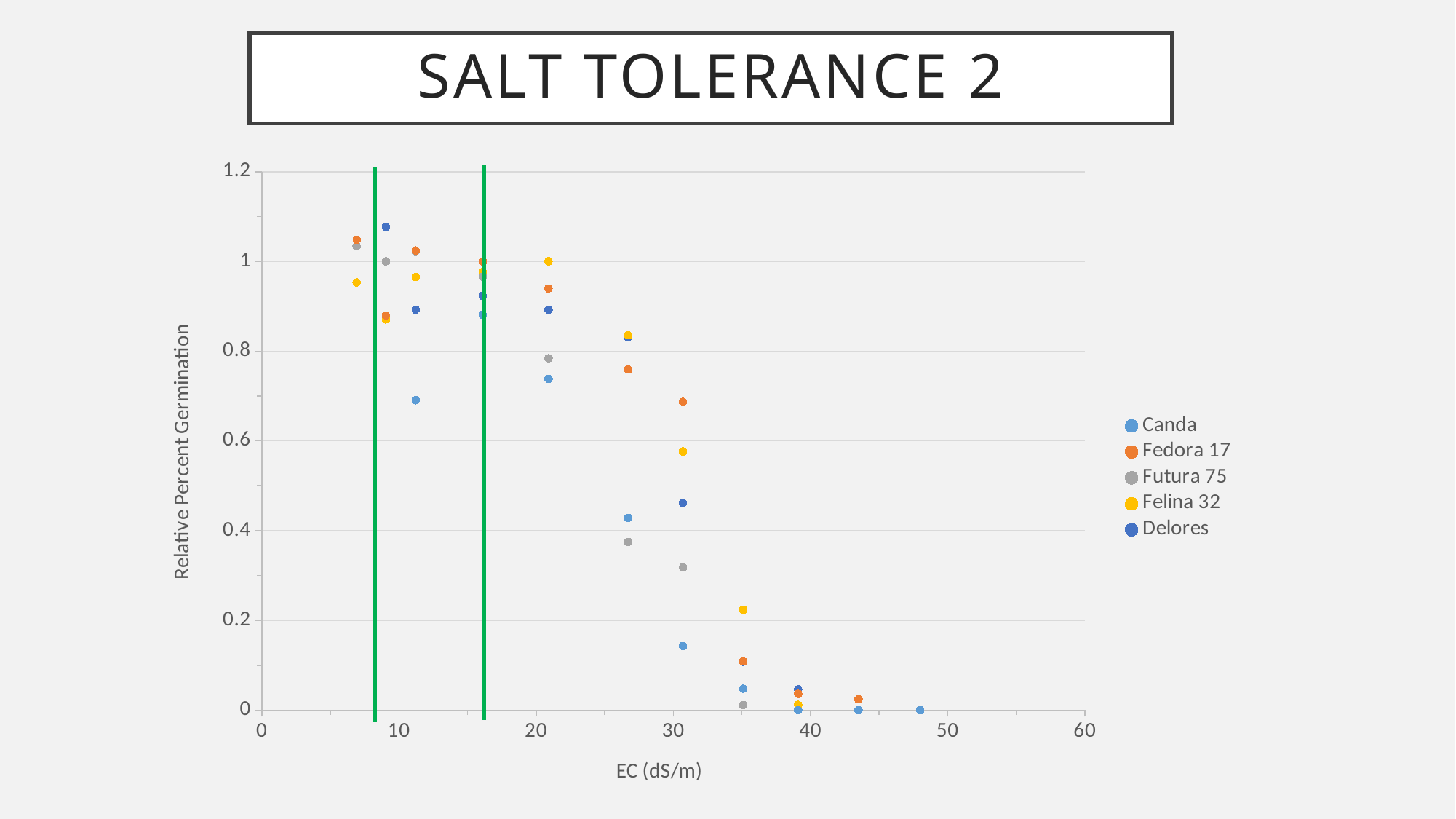
How many series does the legend list? 5 Is the Canda value at an EC of about 11 dS/m greater or less than 0.8? less Which series has the highest value at an EC of about 35 dS/m? Felina 32 Is the Fedora 17 value at an EC of about 31 dS/m greater or less than 0.6? greater Is the Futura 75 value at an EC of about 31 dS/m greater or less than 0.4? less What is the title of the slide's chart? SALT TOLERANCE 2 At an EC of about 31 dS/m, which is larger: the Fedora 17 value or the Futura 75 value? Fedora 17 What kind of chart is shown on the slide? Scatter chart At an EC of about 27 dS/m, which is larger: the Felina 32 value or the Futura 75 value? Felina 32 What is the label on the x axis of the chart? EC (dS/m) Overall, do the relative percent germination values rise or fall as EC increases? Fall